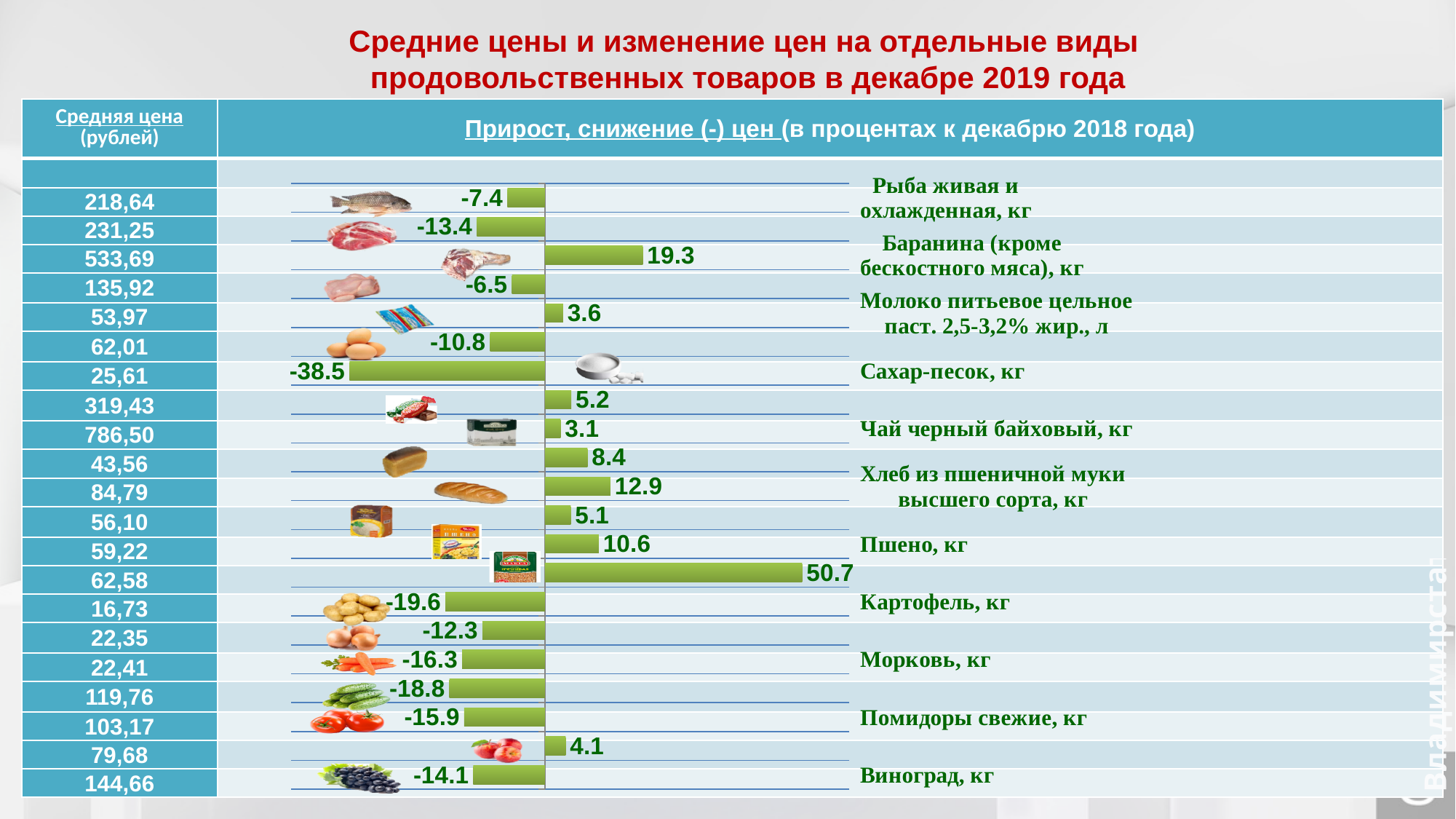
What is the price change value shown for Виноград, кг? -14.1 What is the price change value shown for Баранина (кроме бескостного мяса), кг? 19.3 What is the price change value shown for Сахар-песок, кг? -38.5 What is the highest price change value shown on the chart? 50.7 Which labelled category has the lowest price change value? Сахар-песок, кг What is the difference between the price change values for Картофель, кг and Морковь, кг? 3.3 How many bars are plotted on the chart? 21 What is the price change value shown for Пшено, кг? 10.6 What kind of chart is shown on the slide? Bar chart What is the price change value shown for Помидоры свежие, кг? -15.9 What is the price change value shown for Картофель, кг? -19.6 Which has the larger price change value: Баранина (кроме бескостного мяса), кг or Чай черный байховый, кг? Баранина (кроме бескостного мяса), кг